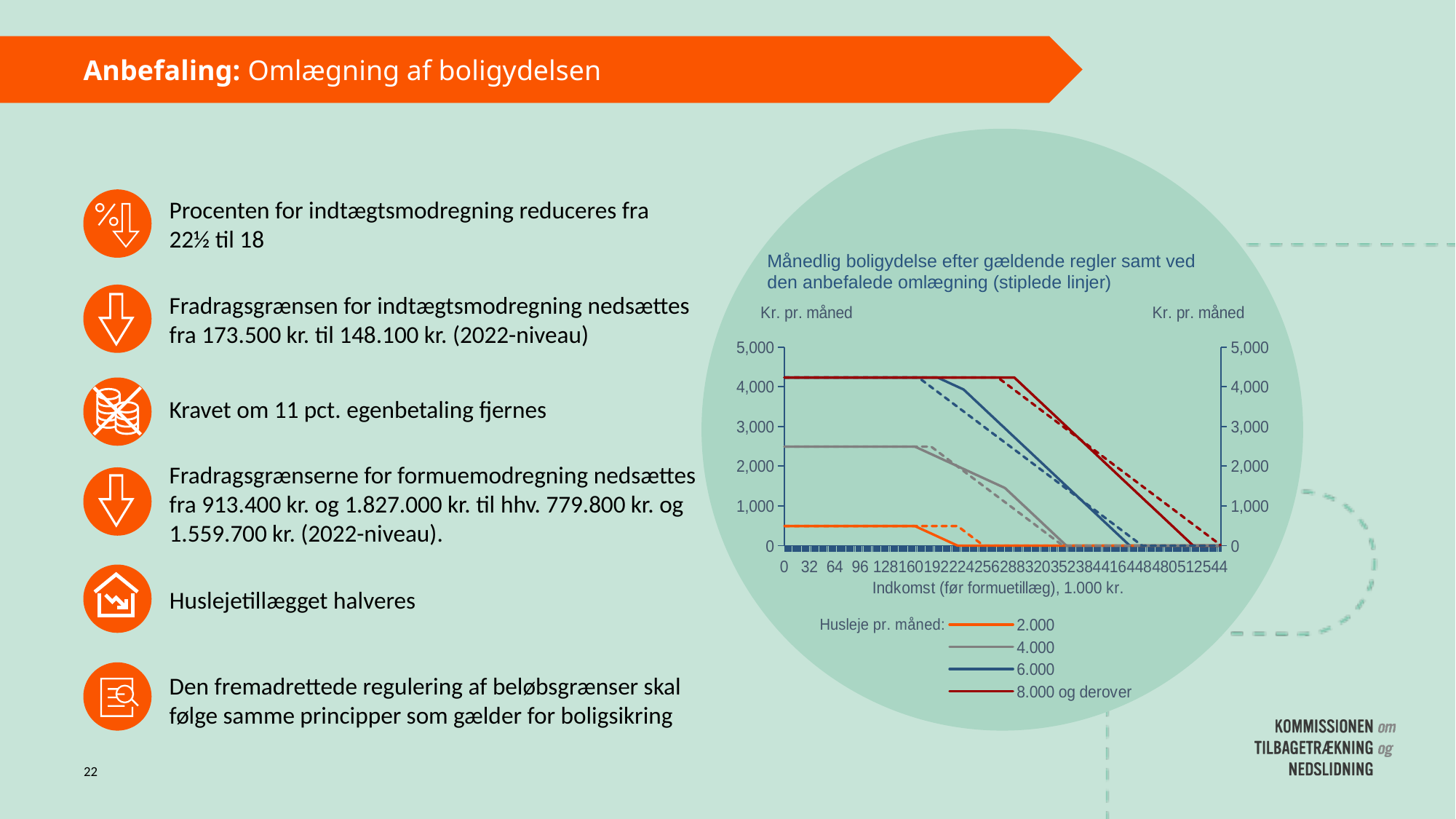
What is the label of the x axis of the chart? Indkomst (før formuetillæg), 1.000 kr. At an income of 0, is the value for the 8.000 og derover series greater or less than 3,000? greater Which series has the highest value at an income of 0? 6.000 and 8.000 og derover (tied) At an income of 0, is the value for the 2.000 series greater or less than 1,000? less Which series has the lowest value at an income of 0? 2.000 At an income of 0, is the value for the 4.000 series greater or less than 2,000? greater What is the title of the chart? Månedlig boligydelse efter gældende regler samt ved den anbefalede omlægning (stiplede linjer) At an income of 0, which is larger: the value for the 6.000 series or the value for the 2.000 series? 6.000 What kind of chart is shown on the slide? line chart How many series does the chart legend list? 4 Do the plotted values rise or fall as income increases along the x axis? fall